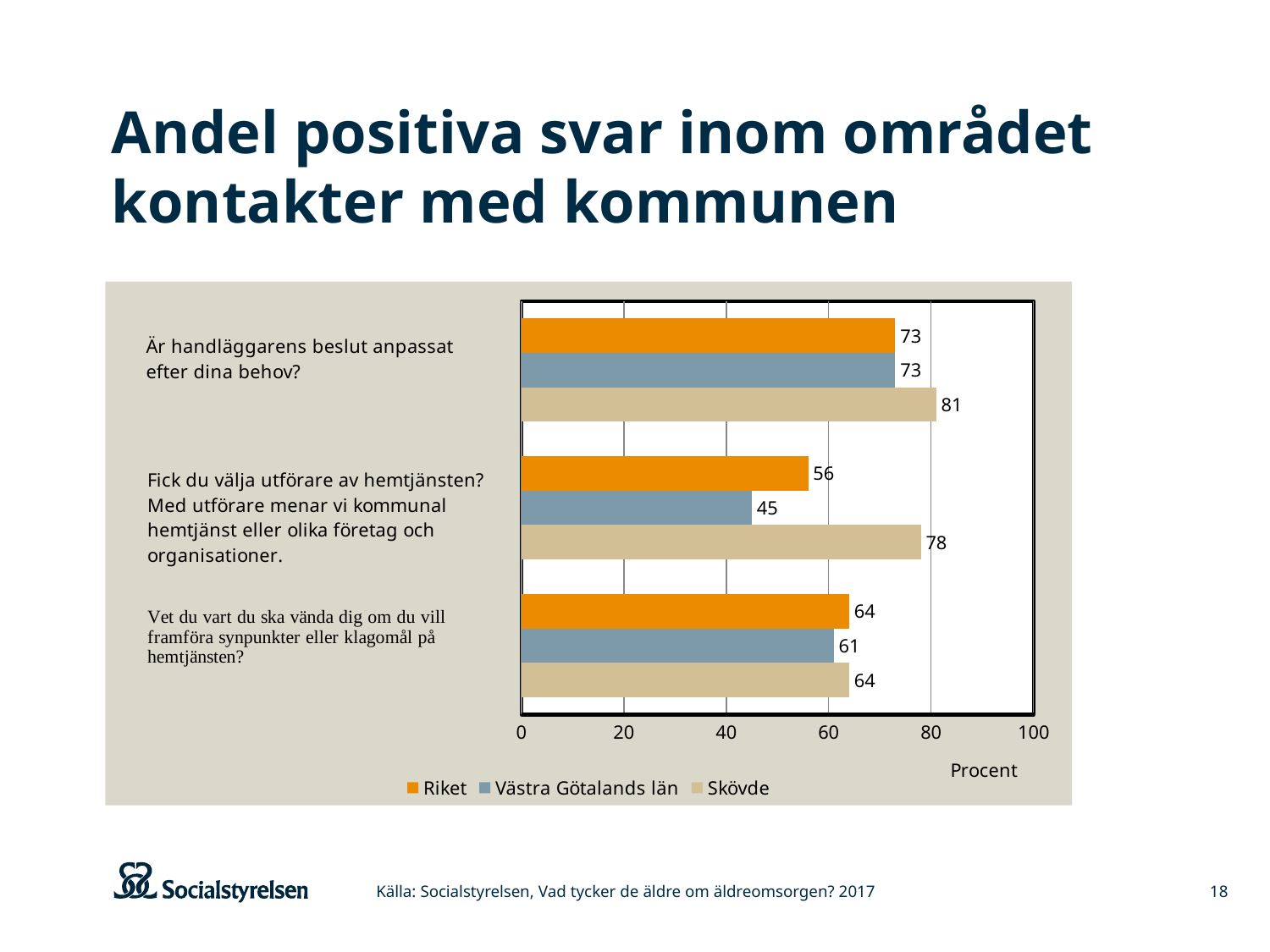
How many question categories are shown on the chart? 3 What is the value for Skövde on the question "Är handläggarens beslut anpassat efter dina behov?"? 81 Which series has the highest value on the question "Fick du välja utförare av hemtjänsten?"? Skövde How many series does the legend list? 3 Which is larger: Riket or Västra Götalands län on the question "Fick du välja utförare av hemtjänsten?"? Riket What is the difference between Skövde and Riket on the question "Är handläggarens beslut anpassat efter dina behov?"? 8 What is the difference between Skövde and Västra Götalands län on the question "Fick du välja utförare av hemtjänsten?"? 33 What kind of chart is shown on the slide? Bar chart What is the value for Riket on the question "Vet du vart du ska vända dig om du vill framföra synpunkter eller klagomål på hemtjänsten?"? 64 What is the value for Västra Götalands län on the question "Fick du välja utförare av hemtjänsten?"? 45 What unit is shown on the horizontal axis of the chart? Procent Which series has the lowest value on the question "Vet du vart du ska vända dig om du vill framföra synpunkter eller klagomål på hemtjänsten?"? Västra Götalands län